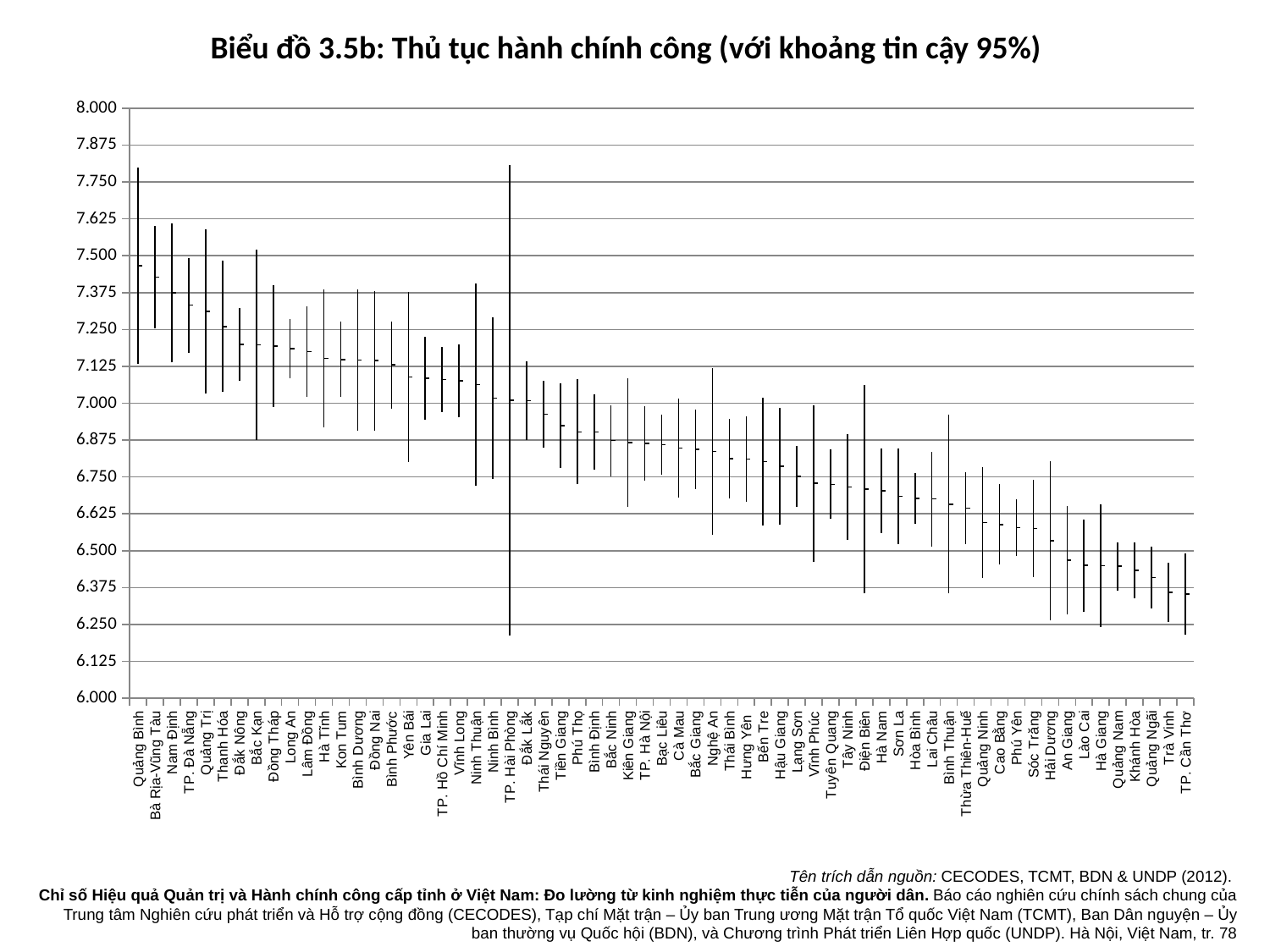
Do the point estimates generally rise or fall moving from left to right along the x axis? fall What is the title of the chart? Biểu đồ 3.5b: Thủ tục hành chính công (với khoảng tin cậy 95%) Is the point estimate for TP. Cần Thơ greater or less than 6.500? less Is the point estimate for Hà Giang greater or less than 6.625? less Is the point estimate for TP. Hà Nội greater or less than 7.000? less Which province has the wider confidence interval, TP. Hải Phòng or Đắk Lắk? TP. Hải Phòng What confidence level is stated in the chart title? 95% How many provinces are shown along the x axis of the chart? 63 Which province has the higher point estimate, Thanh Hóa or Kiên Giang? Thanh Hóa